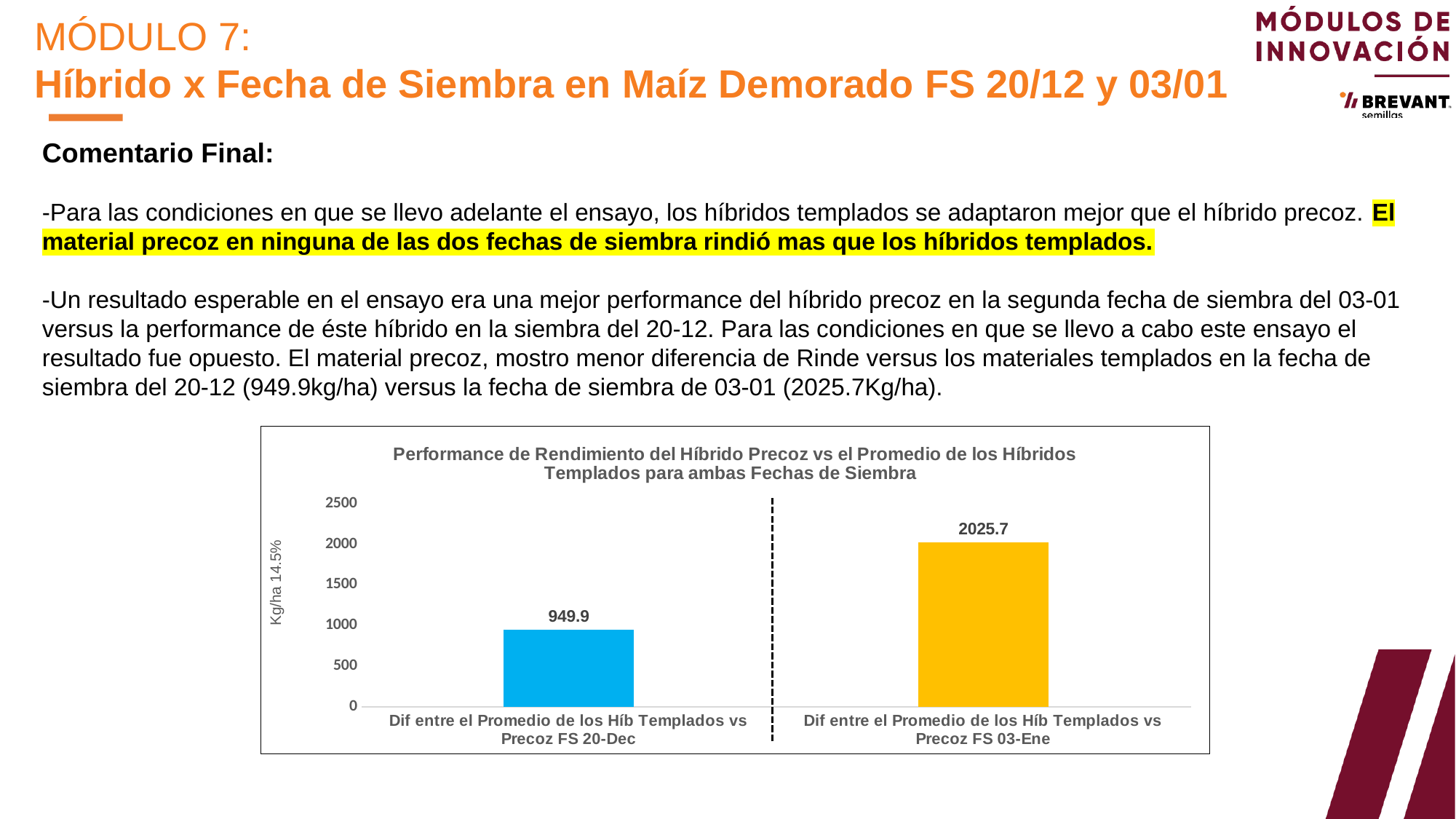
What is the value for 'Dif entre el Promedio de los Híb Templados vs Precoz FS 20-Dec'? 949.9 What is the value for 'Dif entre el Promedio de los Híb Templados vs Precoz FS 03-Ene'? 2025.7 What is the label of the vertical axis of the chart? Kg/ha 14.5% Is the value for FS 20-Dec greater or less than 1000? less What is the difference between the FS 03-Ene value and the FS 20-Dec value? 1075.8 Which category has the lowest value? Dif entre el Promedio de los Híb Templados vs Precoz FS 20-Dec How many bars are plotted in the chart? 2 What kind of chart is shown on the slide? Bar chart Which category has the highest value? Dif entre el Promedio de los Híb Templados vs Precoz FS 03-Ene Which is larger, the value for FS 20-Dec or the value for FS 03-Ene? FS 03-Ene What is the title of the chart? Performance de Rendimiento del Híbrido Precoz vs el Promedio de los Híbridos Templados para ambas Fechas de Siembra Is the value for FS 03-Ene greater or less than 2000? greater